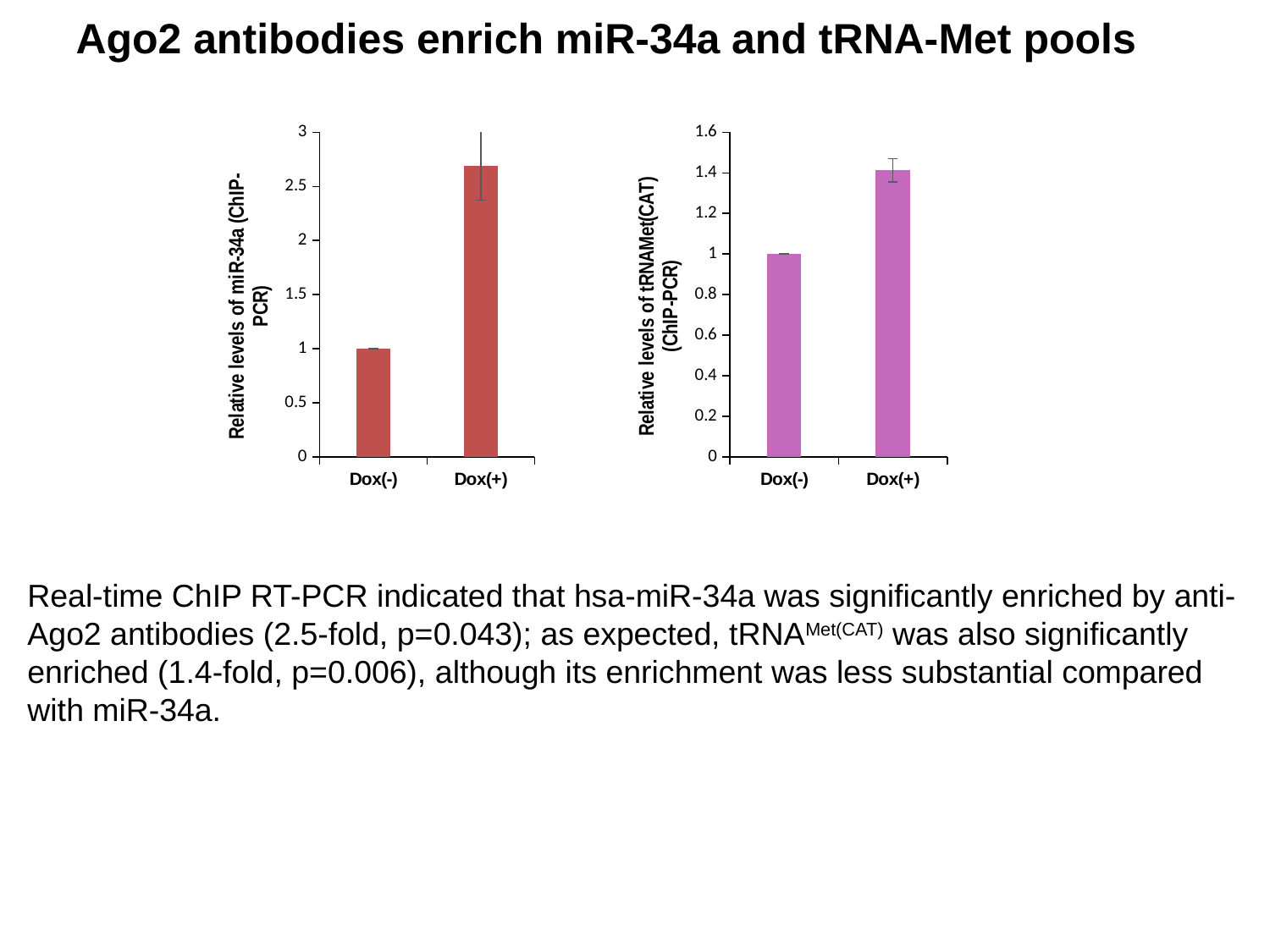
What colour are the bars in the right chart (Relative levels of tRNAMet(CAT))? purple In the left chart (Relative levels of miR-34a), what is the value for Dox(-)? 1 What is the maximum value shown on the y axis of the right chart (Relative levels of tRNAMet(CAT))? 1.6 How many categories are shown on the x axis of the right chart (Relative levels of tRNAMet(CAT))? 2 In the left chart (Relative levels of miR-34a), is the value for Dox(+) greater or less than 2.5? greater In the right chart (Relative levels of tRNAMet(CAT)), which category has the lowest value? Dox(-) In the right chart (Relative levels of tRNAMet(CAT)), which is larger, Dox(-) or Dox(+)? Dox(+) In the left chart (Relative levels of miR-34a), is the value for Dox(+) greater or less than 3? less In the left chart (Relative levels of miR-34a), which category has the highest value? Dox(+) In the right chart (Relative levels of tRNAMet(CAT)), what is the value for Dox(-)? 1 In the right chart (Relative levels of tRNAMet(CAT)), is the value for Dox(+) greater or less than 1.2? greater What kind of chart is the left chart (Relative levels of miR-34a)? bar chart